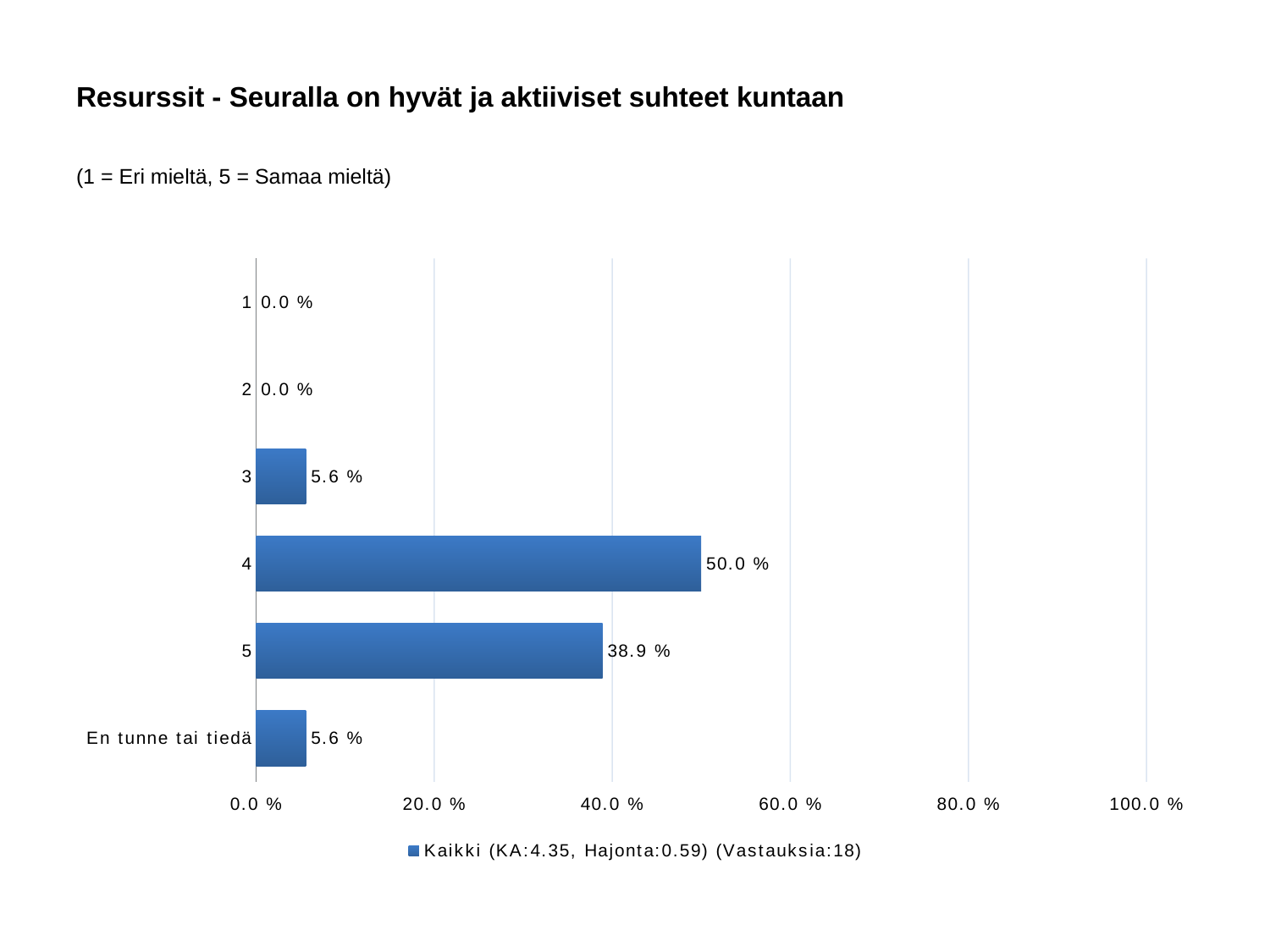
What is the value for category 4? 50.0 % Which is larger, the value for category 4 or category 5? 4 What is the difference between the values for category 4 and category 5? 11.1 % How many categories are shown on the chart? 6 Is the value for category 5 greater or less than 40.0 %? less What is the value for category 5? 38.9 % Which category has the highest value? 4 What is the value for 'En tunne tai tiedä'? 5.6 % How many responses (Vastauksia) does the legend report? 18 What kind of chart is shown on the slide? bar chart What is the value for category 1? 0.0 % What is the value for category 3? 5.6 %